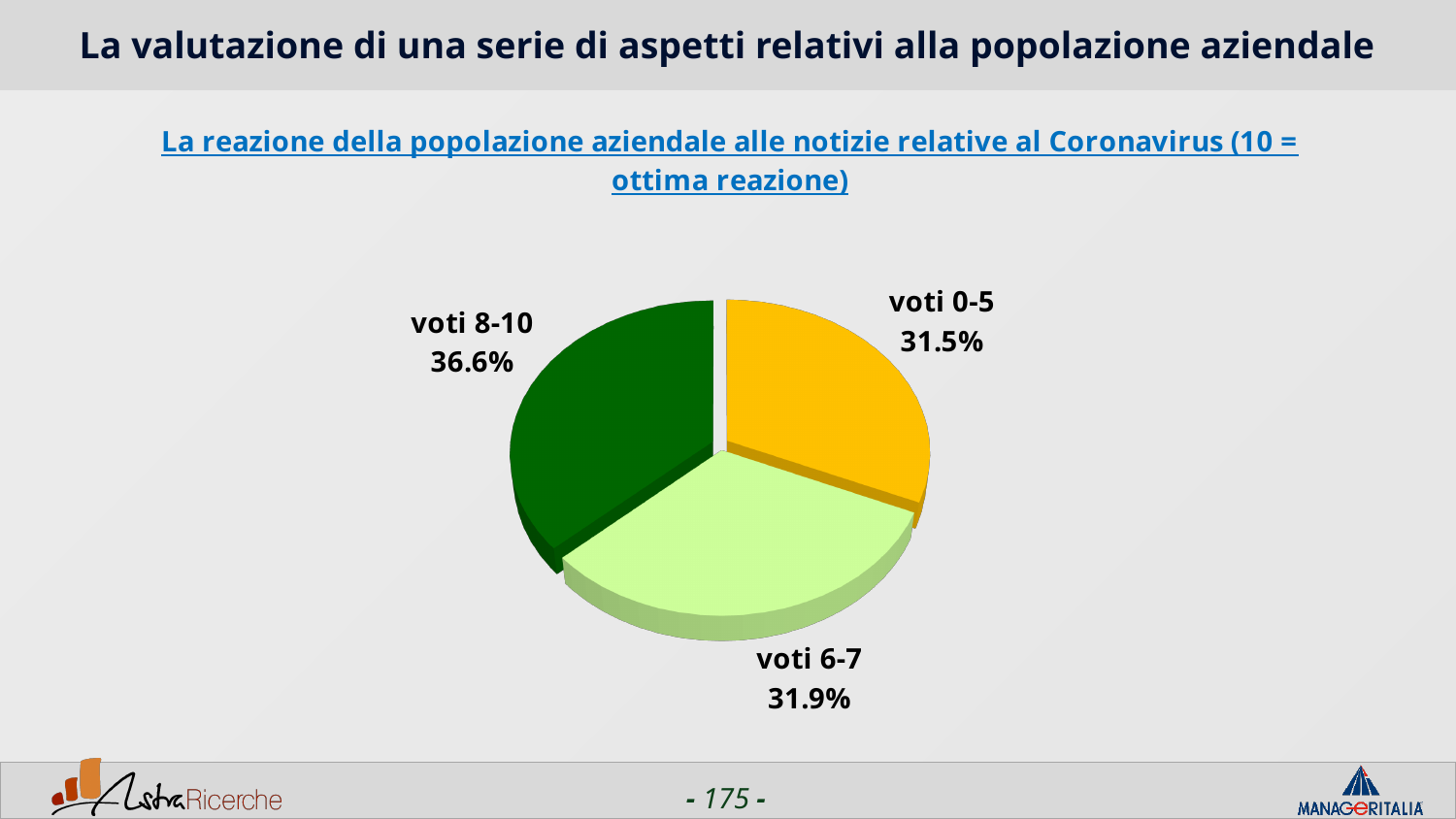
How many slices does the pie chart have? 3 Which slice of the pie is the smallest? voti 0-5 Which slice is larger, 'voti 8-10' or 'voti 0-5'? voti 8-10 What kind of chart is shown on the slide? pie chart What colour is the 'voti 0-5' slice? orange/yellow What is the title of the chart? La reazione della popolazione aziendale alle notizie relative al Coronavirus (10 = ottima reazione) What is the difference in percentage points between the 'voti 8-10' slice and the 'voti 0-5' slice? 5.1 What share of the pie does the slice 'voti 0-5' represent? 31.5% What share of the pie does the slice 'voti 6-7' represent? 31.9% What is the difference in percentage points between the 'voti 8-10' slice and the 'voti 6-7' slice? 4.7 Which slice of the pie is the largest? voti 8-10 What share of the pie does the slice 'voti 8-10' represent? 36.6%